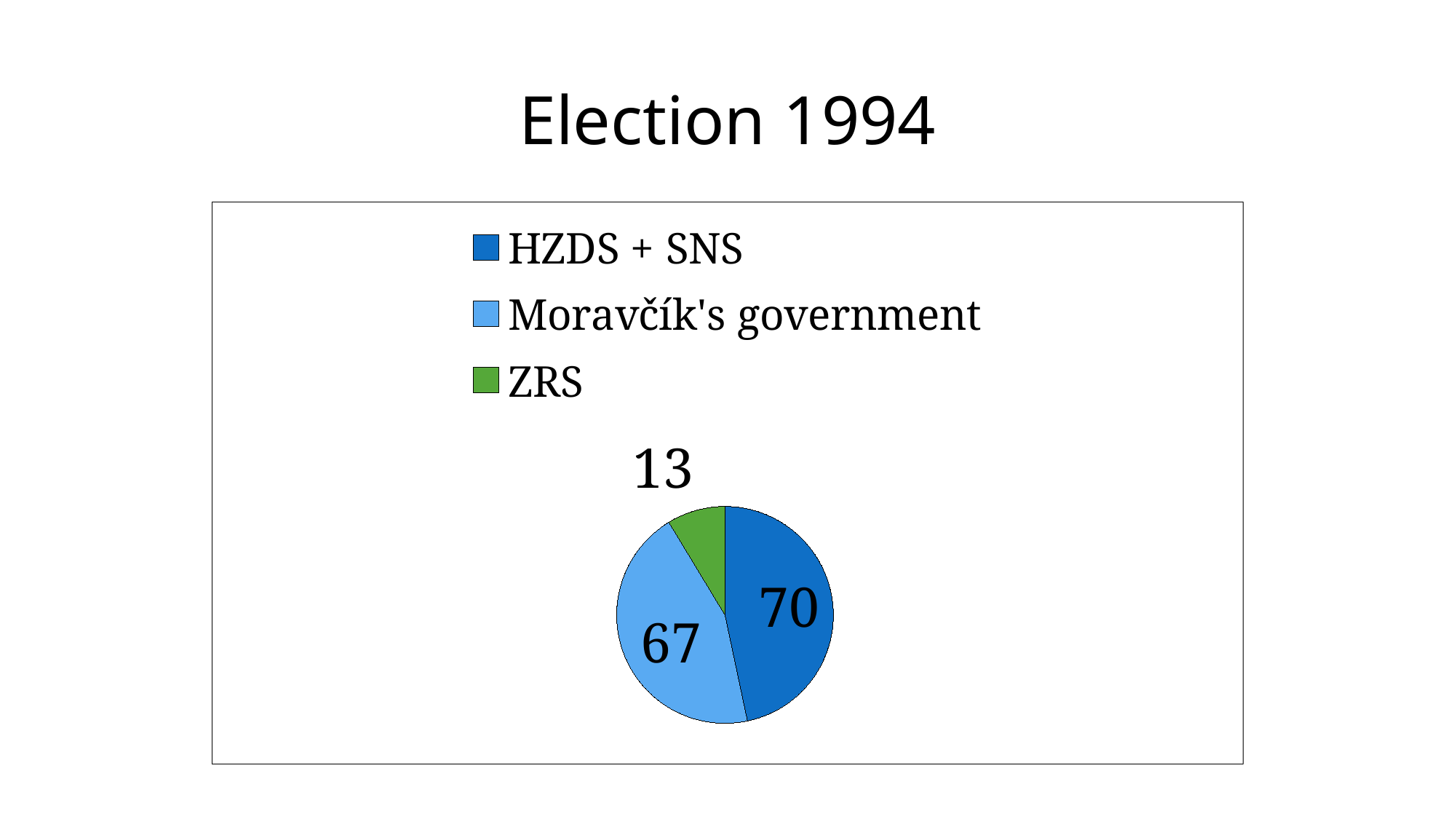
What is the difference between the values for HZDS + SNS and Moravčík's government? 3 Which category has the smallest slice of the pie? ZRS What is the difference between the values for Moravčík's government and ZRS? 54 What is the total of all the slices in the pie chart? 150 What is the title of the chart? Election 1994 Which is larger, the value for Moravčík's government or the value for ZRS? Moravčík's government Which category has the largest slice of the pie? HZDS + SNS How many slices does the pie chart have? 3 What value is shown for ZRS? 13 What value is shown for Moravčík's government? 67 What kind of chart is shown on the slide? Pie chart What value is shown for HZDS + SNS? 70